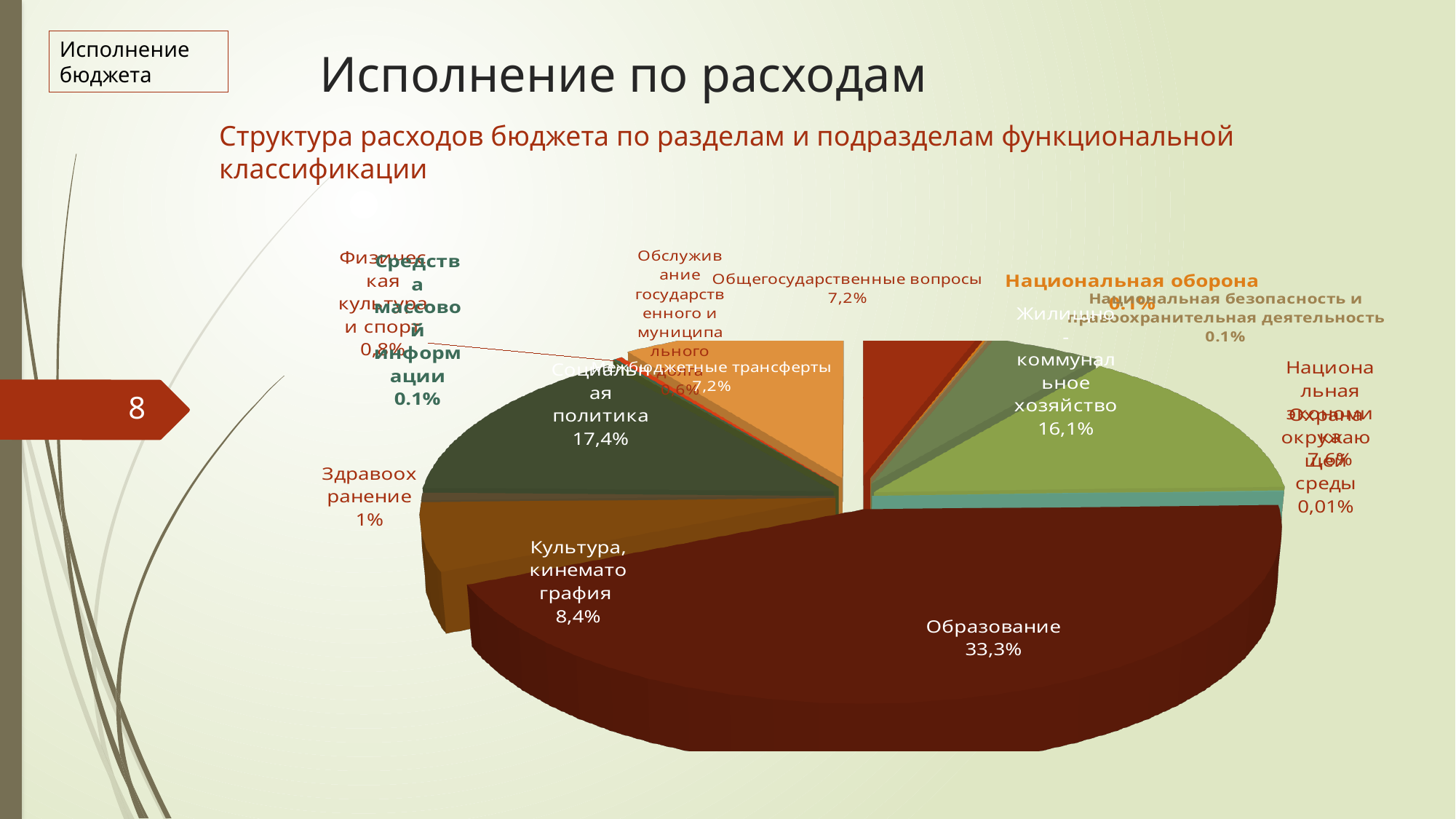
What value is shown for Здравоохранение? 1% By how many percentage points does Образование exceed Социальная политика? 15,9 What share of expenditures does Образование account for in the pie chart? 33,3% What percentage is labelled for Общегосударственные вопросы? 7,2% Which is larger: the share for Социальная политика or for Жилищно-коммунальное хозяйство? Социальная политика What percentage is shown for Социальная политика? 17,4% What is the subtitle describing the chart on the slide? Структура расходов бюджета по разделам и подразделам функциональной классификации What is the value labelled for Жилищно-коммунальное хозяйство? 16,1% Which category has the largest share of the pie chart? Образование What percentage is shown for Межбюджетные трансферты? 7,2% What type of chart is shown on the slide? Pie chart What share is shown for Культура, кинематография? 8,4%